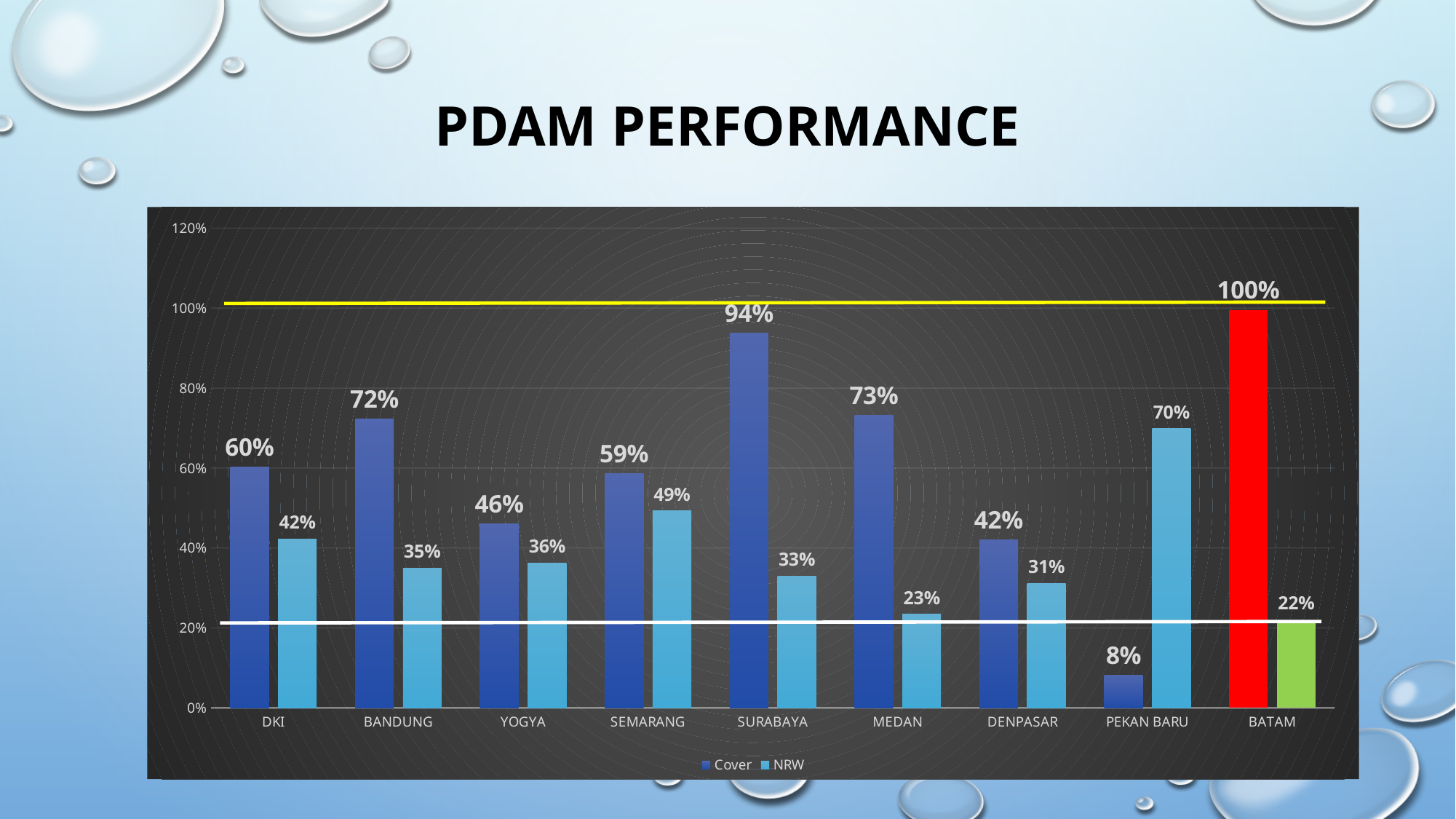
What is the NRW value for Pekan Baru? 70% How many series does the legend list? 2 Which is larger for Semarang, the Cover value or the NRW value? Cover What is the difference between the Cover and NRW values for Bandung? 37% Which city has the lowest NRW value? Batam What is the Cover value for Surabaya? 94% Which city has the highest Cover value? Batam What is the NRW value for Medan? 23% How many cities are shown on the x axis? 9 Which city has the lowest Cover value? Pekan Baru What is the title of the slide? PDAM PERFORMANCE What kind of chart is shown on the slide? Bar chart